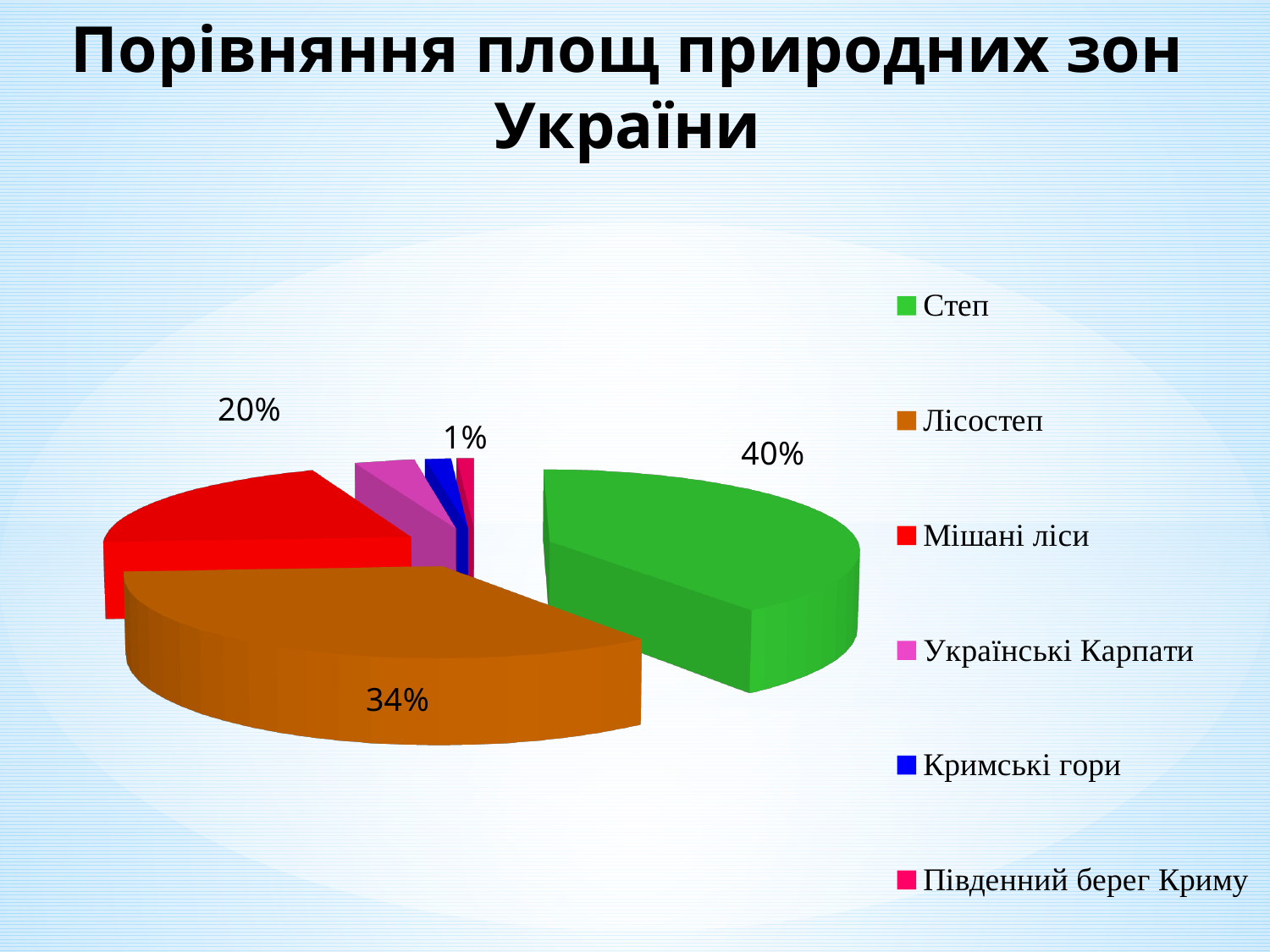
What is the title of the chart? Порівняння площ природних зон України What is the difference between the shares of Лісостеп and Мішані ліси? 14% What is the difference between the shares of Степ and Лісостеп? 6% What is the value shown for Мішані ліси? 20% How many categories does the legend list? 6 What share of the pie does Степ take? 40% What colour is the slice for Степ? green What is the value shown for Лісостеп? 34% Which is larger, the share of Лісостеп or the share of Мішані ліси? Лісостеп What kind of chart is shown on the slide? pie chart Which category has the largest slice of the pie? Степ Which is larger, the share of Степ or the share of Мішані ліси? Степ